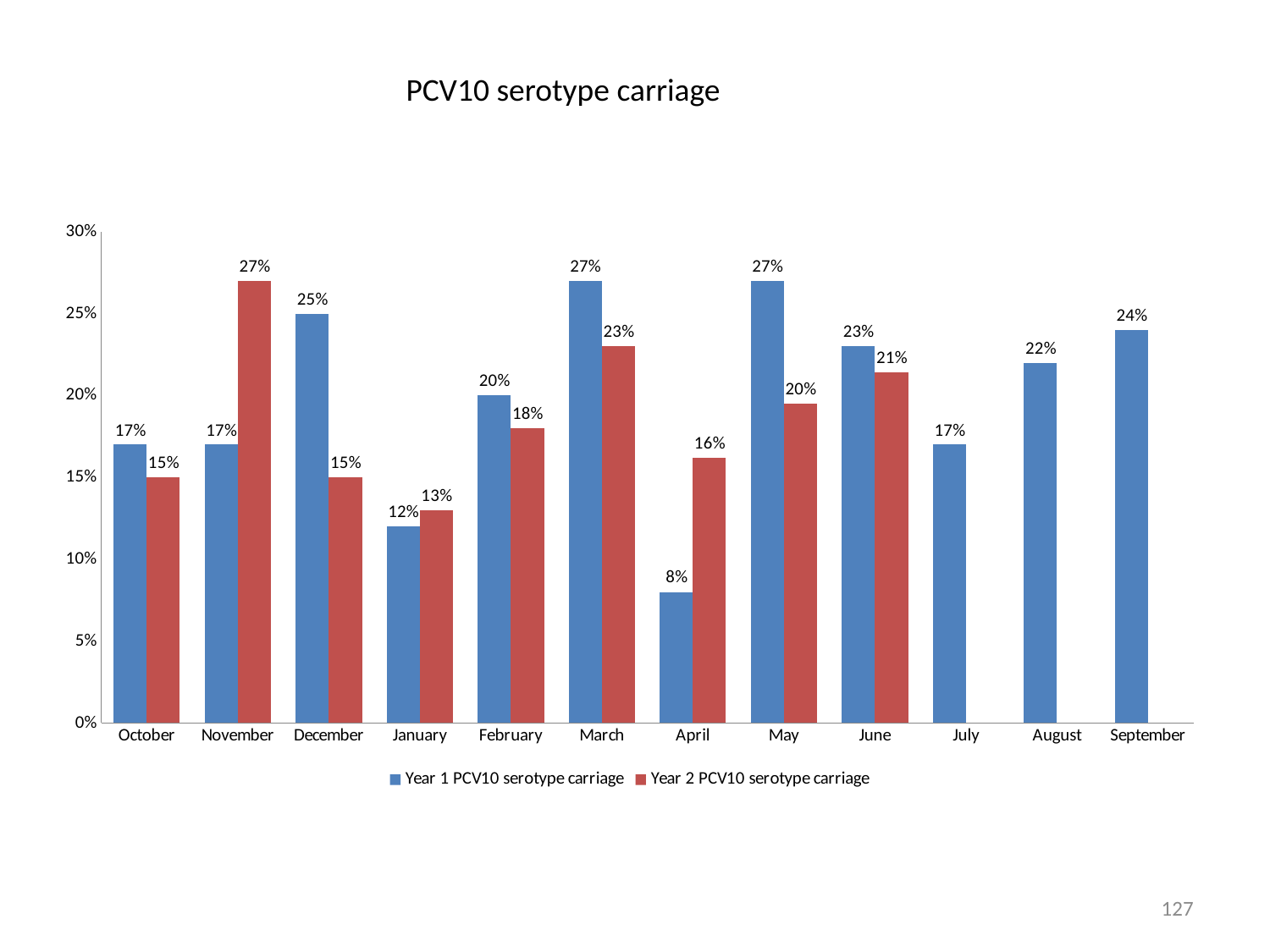
What is the Year 2 PCV10 serotype carriage value for April? 16% What is the difference between the Year 1 and Year 2 PCV10 serotype carriage values in December? 10% What colour are the Year 2 PCV10 serotype carriage bars? Red What kind of chart is shown on the slide? Bar chart How many months are shown on the x axis? 12 How many series does the legend list? 2 What is the Year 1 PCV10 serotype carriage value for December? 25% Which month has the lowest Year 1 PCV10 serotype carriage? April What is the title of the chart? PCV10 serotype carriage Which is larger in November: the Year 1 or the Year 2 PCV10 serotype carriage value? Year 2 PCV10 serotype carriage Is the Year 1 PCV10 serotype carriage value for September greater or less than 20%? greater Which month has the highest Year 2 PCV10 serotype carriage? November